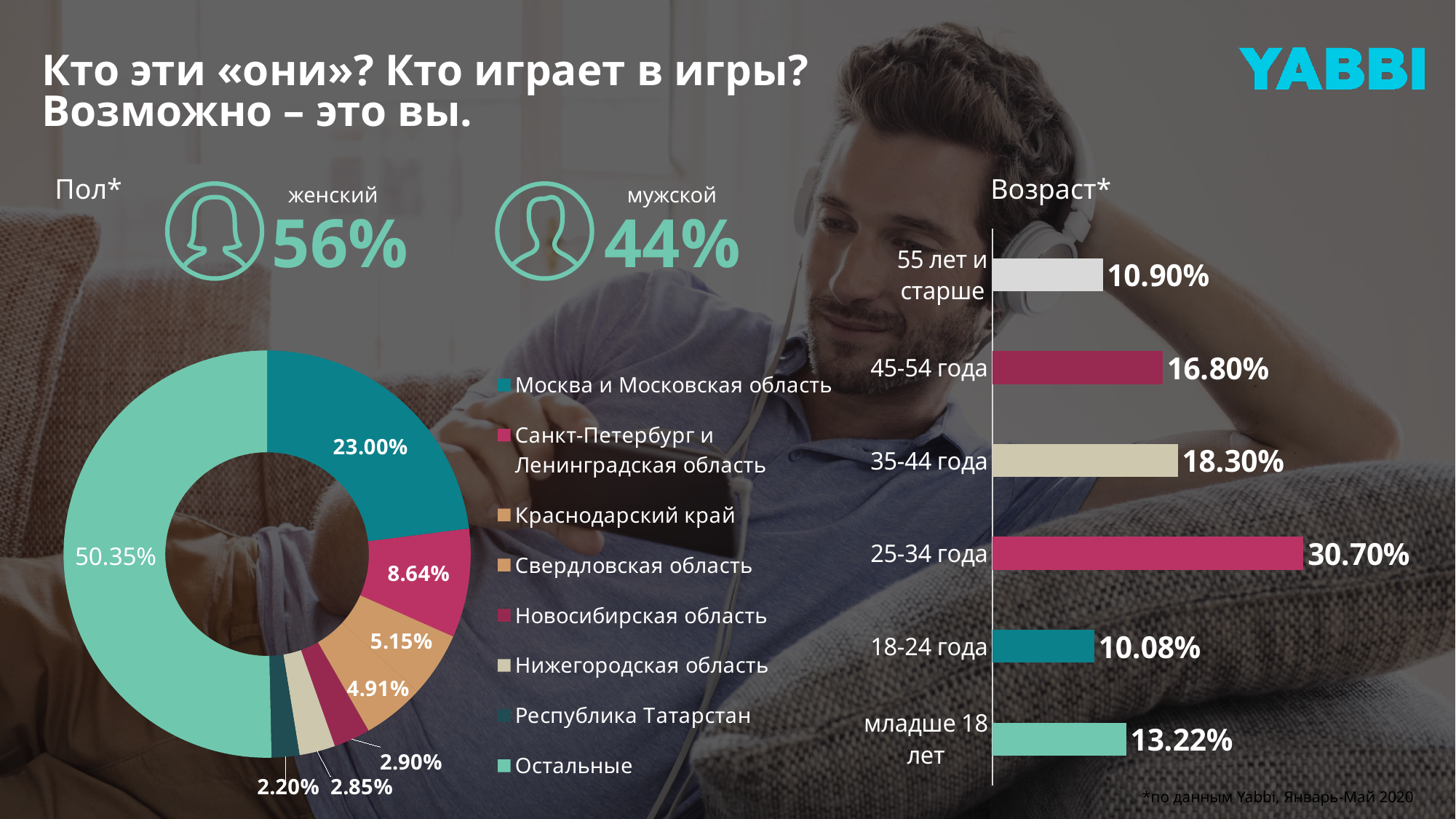
In the age chart (Возраст*), which age group has the lowest value? 18-24 года In the donut chart of regions, which is larger: Краснодарский край or Свердловская область? Краснодарский край What kind of chart is the age chart (Возраст*)? bar chart In the donut chart of regions, what is the share for Санкт-Петербург и Ленинградская область? 8.64% In the age chart (Возраст*), how many age groups are shown? 6 In the age chart (Возраст*), what is the value for младше 18 лет? 13.22% How many entries does the legend of the donut chart of regions list? 8 In the donut chart of regions, what is the share for Москва и Московская область? 23.00% In the age chart (Возраст*), which age group has the highest value? 25-34 года In the age chart (Возраст*), what is the value for 25-34 года? 30.70% In the age chart (Возраст*), what is the difference between the values for 35-44 года and 45-54 года? 1.50% In the donut chart of regions, which region has the smallest share? Республика Татарстан